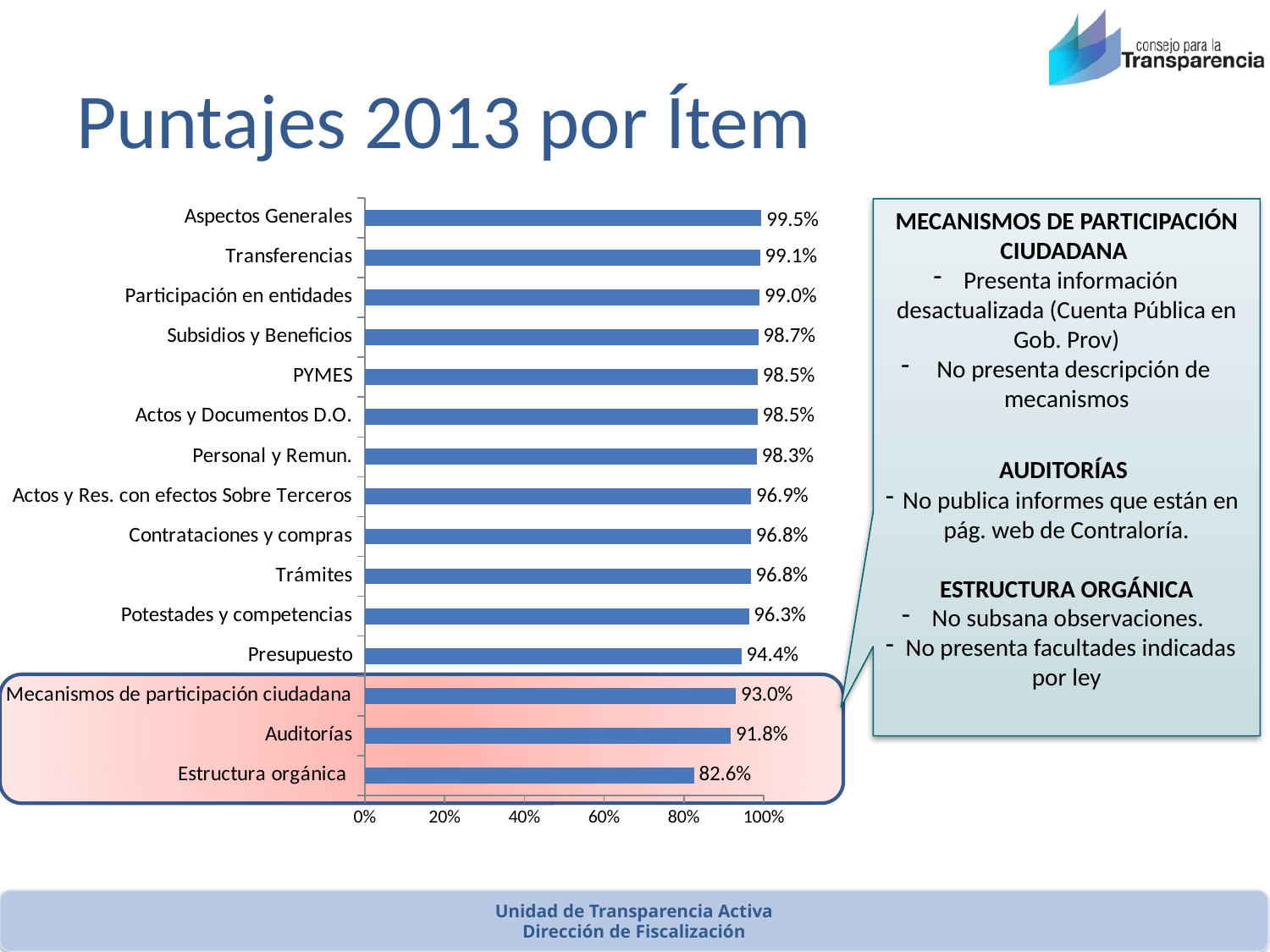
What is the difference between the values for Aspectos Generales and Estructura orgánica? 16.9% What is the value for Estructura orgánica? 82.6% What is the value for Aspectos Generales? 99.5% What kind of chart is shown on the slide? Bar chart Is the value for Estructura orgánica greater or less than 80%? greater How many categories are shown in the chart? 15 Which category has the highest value? Aspectos Generales What is the difference between the values for Mecanismos de participación ciudadana and Auditorías? 1.2% What is the value for Auditorías? 91.8% Which category has the lowest value? Estructura orgánica Which is larger, the value for Presupuesto or the value for Auditorías? Presupuesto What is the value for Presupuesto? 94.4%